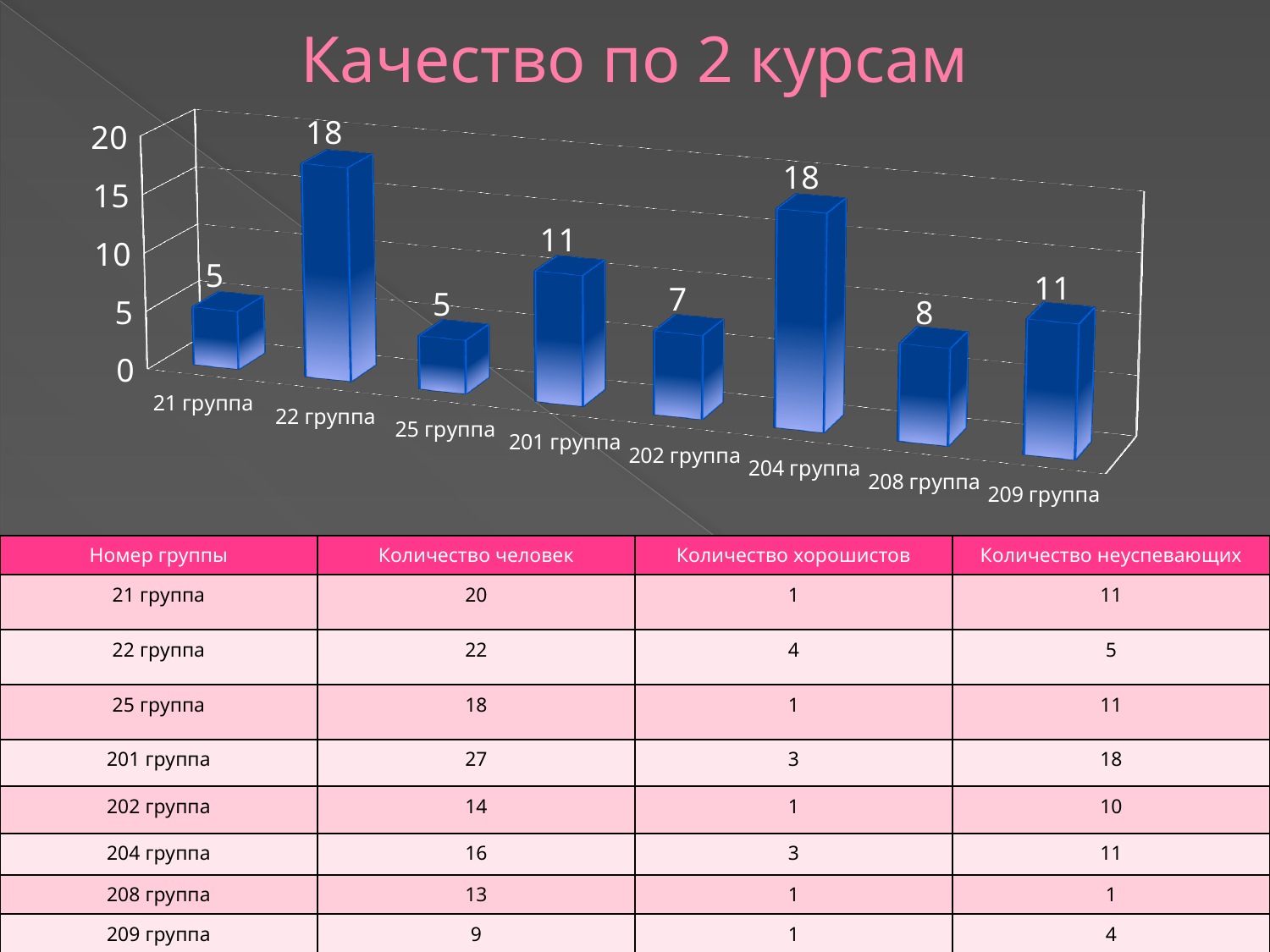
What is the value shown for 202 группа? 7 What is the difference between the values for 22 группа and 25 группа? 13 What kind of chart is shown on the slide? Bar chart Which has a larger value, 201 группа or 202 группа? 201 группа What is the value shown for 209 группа? 11 What is the value shown for 22 группа? 18 What is the difference between the values for 204 группа and 208 группа? 10 What is the title of the chart? Качество по 2 курсам What is the value shown for 208 группа? 8 How many groups are shown on the chart? 8 What is the value shown for 201 группа? 11 Which has a larger value, 21 группа or 208 группа? 208 группа